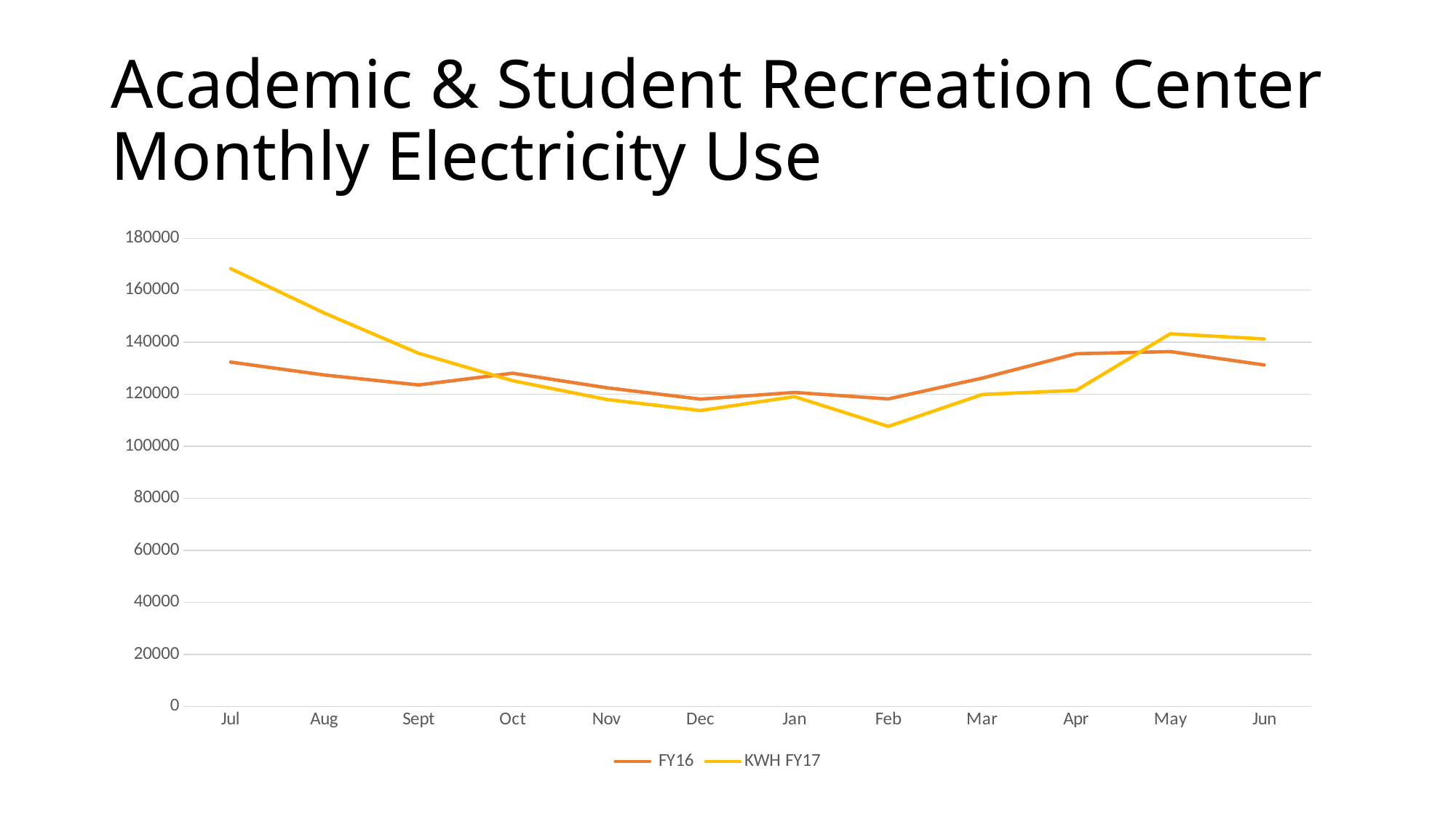
In Apr, which series has the larger value, FY16 or KWH FY17? FY16 Does the KWH FY17 line rise or fall from Jul to Dec? fall Is the KWH FY17 value for Jul greater or less than 160000? greater In which month is the KWH FY17 value lowest? Feb Is the FY16 value for Jul greater or less than 120000? greater In Jul, which series has the larger value, FY16 or KWH FY17? KWH FY17 How many months are plotted along the x axis? 12 What kind of chart is shown on the slide? line chart How many series does the legend list? 2 Is the KWH FY17 value for Feb greater or less than 120000? less In which month is the KWH FY17 value highest? Jul What is the title of the slide containing the chart? Academic & Student Recreation Center Monthly Electricity Use